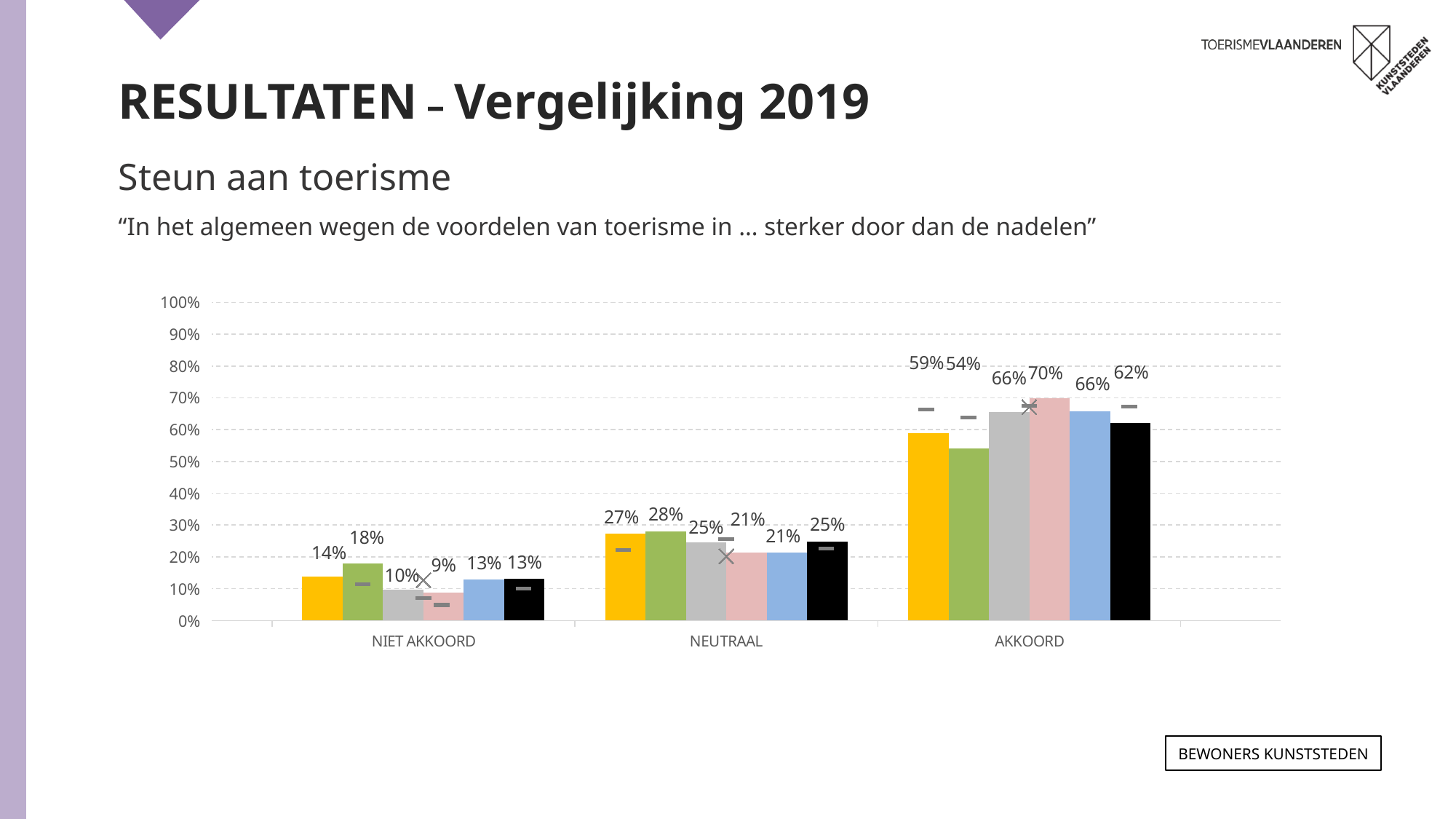
What are the three category labels on the x axis of the chart? NIET AKKOORD, NEUTRAAL, AKKOORD What is the value of the yellow bar in the AKKOORD category? 59% What is the value of the pink bar in the NIET AKKOORD category? 9% What kind of chart is shown on the slide? bar chart What is the value of the black bar in the NEUTRAAL category? 25% How many categories are shown on the x axis of the chart? 3 Which coloured bar is the highest in the AKKOORD category? pink (70%) What is the difference between the pink bar and the yellow bar in the AKKOORD category? 11 percentage points Which coloured bar is the lowest in the NIET AKKOORD category? pink (9%) In the NEUTRAAL category, which is larger: the green bar or the yellow bar? green bar (28%) How many bars are plotted in each category of the chart? 6 Is the value of the black bar in the AKKOORD category greater or less than 50%? greater